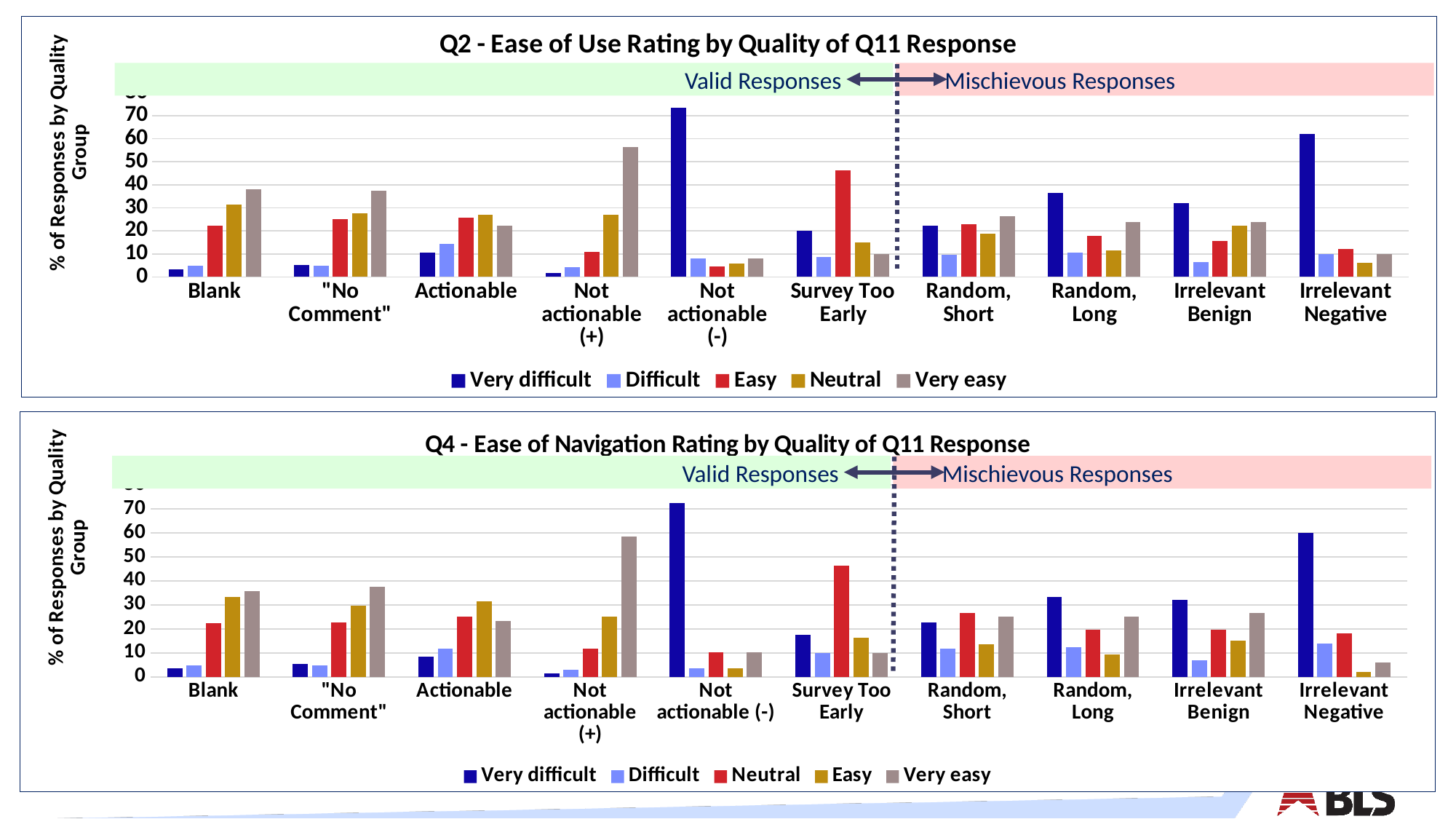
In the top chart (Q2 - Ease of Use Rating), is the 'Easy' value for 'Survey Too Early' greater or less than 40? greater What type of chart is the top chart, 'Q2 - Ease of Use Rating by Quality of Q11 Response'? Bar chart In the bottom chart (Q4 - Ease of Navigation Rating), for 'Random, Long', which is larger: 'Very difficult' or 'Easy'? Very difficult In the bottom chart (Q4 - Ease of Navigation Rating), which category has the highest 'Very difficult' bar? Not actionable (-) In the top chart (Q2 - Ease of Use Rating), is the 'Very easy' value for 'Not actionable (+)' greater or less than 50? greater In the top chart (Q2 - Ease of Use Rating), is the 'Very difficult' value for 'Not actionable (-)' greater or less than 70? greater In the top chart (Q2 - Ease of Use Rating), which category has the highest 'Very difficult' bar? Not actionable (-) In the top chart (Q2 - Ease of Use Rating), for the 'Blank' category, which is larger: 'Very easy' or 'Easy'? Very easy How many response-quality categories are shown on the x axis of the bottom chart (Q4 - Ease of Navigation Rating)? 10 How many series does the legend of the top chart (Q2 - Ease of Use Rating) list? 5